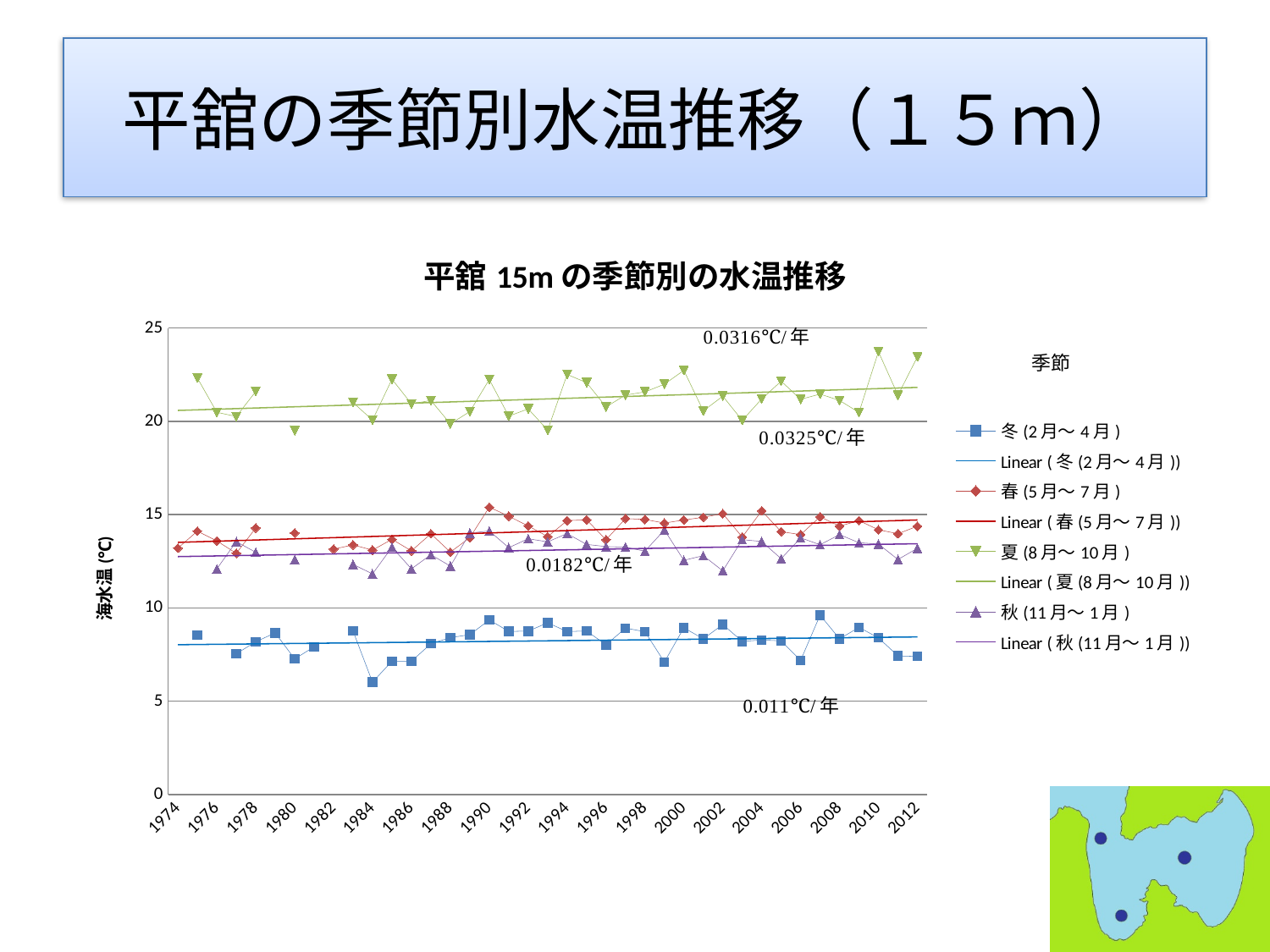
What is the largest slope value annotated on the chart? 0.0325℃/年 Does the linear trend line for 冬 (2月～4月) rise or fall from 1974 to 2012? rise What is the title of the chart? 平舘 15m の季節別の水温推移 How many entries does the chart legend list? 8 Is the 冬 (2月～4月) value for 1984 greater or less than 10? less What kind of chart is shown on the slide? line chart In 2000, which series has the larger value, 夏 (8月～10月) or 冬 (2月～4月)? 夏 (8月～10月) What is the smallest slope value annotated on the chart? 0.011℃/年 Which season series has the highest water temperatures across the chart? 夏 (8月～10月) Is the 夏 (8月～10月) value for 2010 greater or less than 20? greater What is the label of the vertical axis? 海水温 (℃) Is the 秋 (11月～1月) value for 1990 greater or less than 10? greater